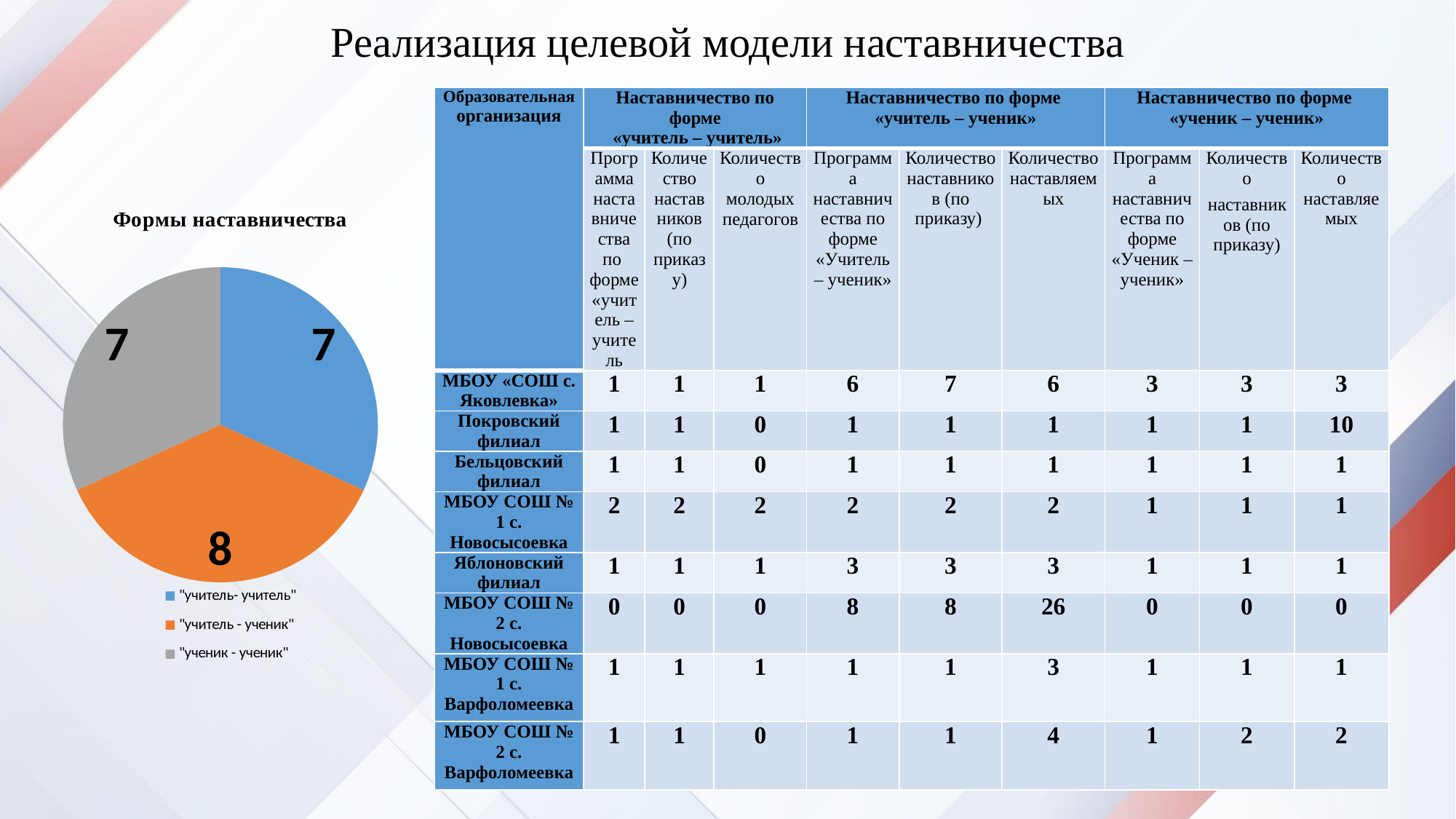
How many slices does the pie chart have? 3 What is the difference between the values for "учитель - ученик" and "ученик - ученик"? 1 What is the value for "учитель- учитель" in the pie chart? 7 How many entries does the legend of the pie chart list? 3 Which category has the largest slice in the pie chart? "учитель - ученик" Which is larger: the value for "учитель - ученик" or the value for "учитель- учитель"? "учитель - ученик" What type of chart is shown on the slide? pie chart What is the value for "учитель - ученик" in the pie chart? 8 What is the title of the chart? Формы наставничества Which colour represents "ученик - ученик" in the pie chart? gray What is the value for "ученик - ученик" in the pie chart? 7 What is the total of all slices in the pie chart? 22